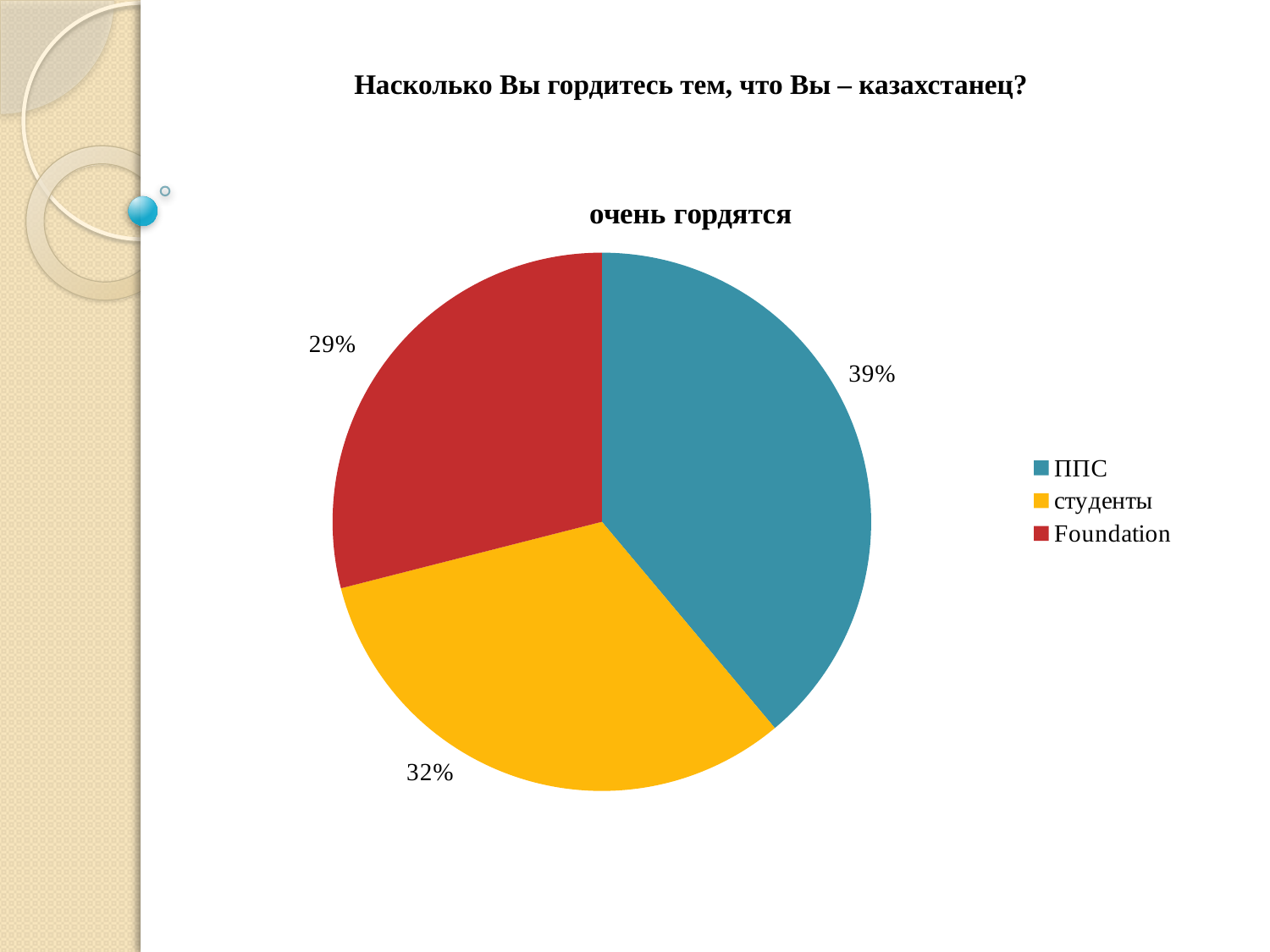
How many slices does the pie chart have? 3 What colour is the Foundation slice? red What is the difference in percentage points between the студенты slice and the Foundation slice? 3 What kind of chart is shown on the slide? pie chart What is the difference in percentage points between the ППС slice and the Foundation slice? 10 Which category has the largest slice of the pie? ППС Which is larger, the ППС slice or the студенты slice? ППС What percentage does the Foundation slice show? 29% What percentage does the ППС slice show? 39% Which category has the smallest slice of the pie? Foundation What is the title of the chart? очень гордятся What percentage does the студенты slice show? 32%